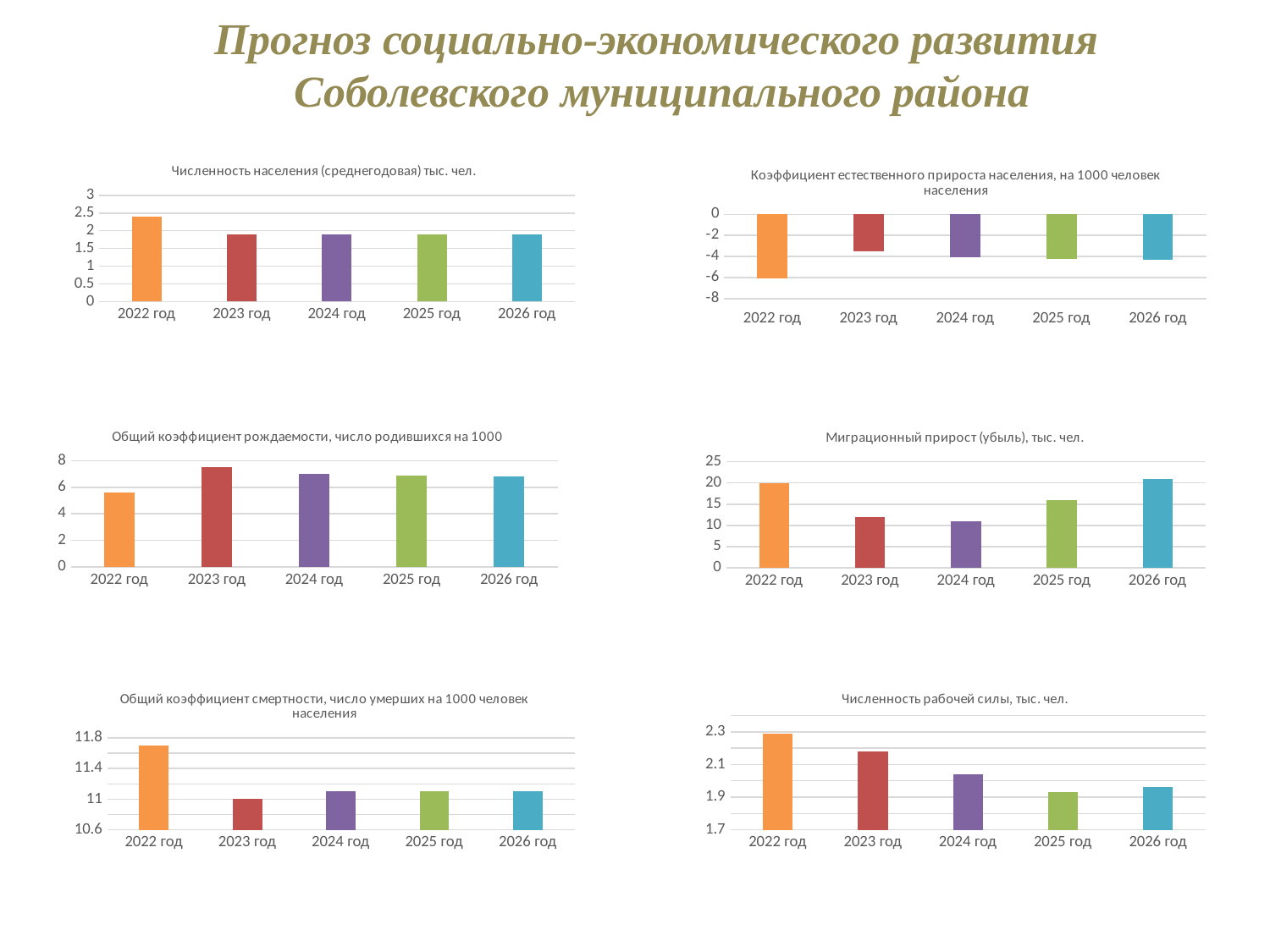
On the chart titled 'Общий коэффициент рождаемости, число родившихся на 1000', which year has the highest value? 2023 год On the chart titled 'Общий коэффициент рождаемости, число родившихся на 1000', is the value for 2022 год greater or less than 6? less On the chart titled 'Миграционный прирост (убыль), тыс. чел.', which is larger, the value for 2022 год or 2023 год? 2022 год On the chart titled 'Коэффициент естественного прироста населения, на 1000 человек населения', which year has the lowest value? 2022 год What kind of chart is the one titled 'Миграционный прирост (убыль), тыс. чел.'? bar chart On the chart titled 'Численность рабочей силы, тыс. чел.', do the values rise or fall from 2022 год to 2025 год? fall How many years are shown on the chart titled 'Численность рабочей силы, тыс. чел.'? 5 On the chart titled 'Миграционный прирост (убыль), тыс. чел.', is the value for 2025 год greater or less than 15? greater On the chart titled 'Численность населения (среднегодовая) тыс. чел.', is the value for 2022 год greater or less than 2? greater On the chart titled 'Общий коэффициент смертности, число умерших на 1000 человек населения', which year has the highest value? 2022 год On the chart titled 'Численность населения (среднегодовая) тыс. чел.', which year has the highest value? 2022 год